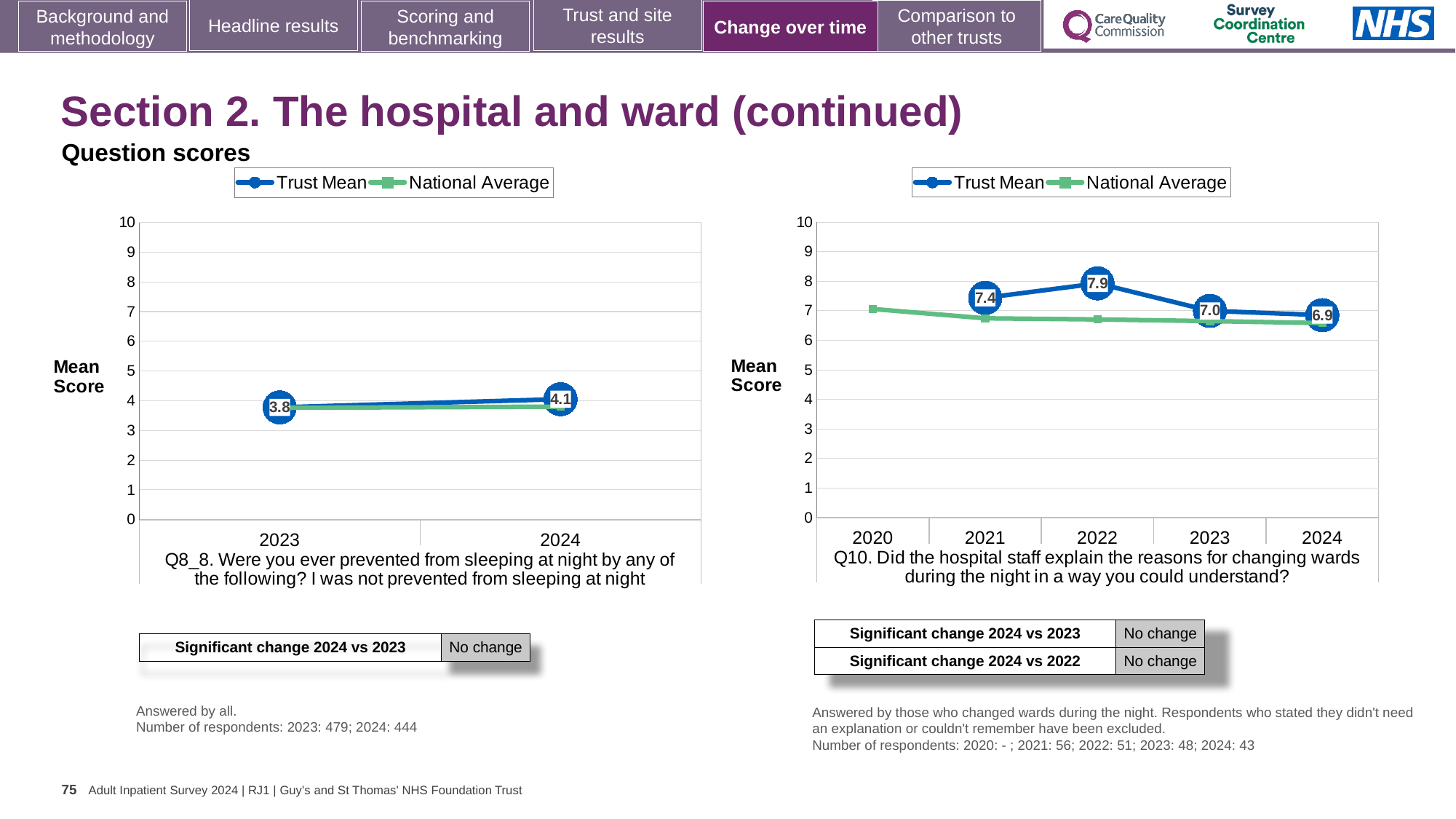
In the Q8_8 chart, does the Trust Mean rise or fall from 2023 to 2024? rise How many series does the legend of the Q8_8 chart list? 2 In the Q10 chart, which year has the lowest labelled Trust Mean score? 2024 In the Q10 chart, what is the difference between the Trust Mean in 2022 and in 2023? 0.9 In the Q8_8 chart, what is the Trust Mean score for 2024? 4.1 In the Q8_8 chart, what is the Trust Mean score for 2023? 3.8 In the Q10 chart, which year has the highest Trust Mean score? 2022 How many years are shown on the x axis of the Q10 chart? 5 In the Q8_8 chart, by how much did the Trust Mean change from 2023 to 2024? 0.3 In the Q10 chart, what is the Trust Mean score for 2024? 6.9 In the Q10 chart, what is the Trust Mean score for 2022? 7.9 In the Q10 chart, is the Trust Mean for 2021 greater or less than 7? greater